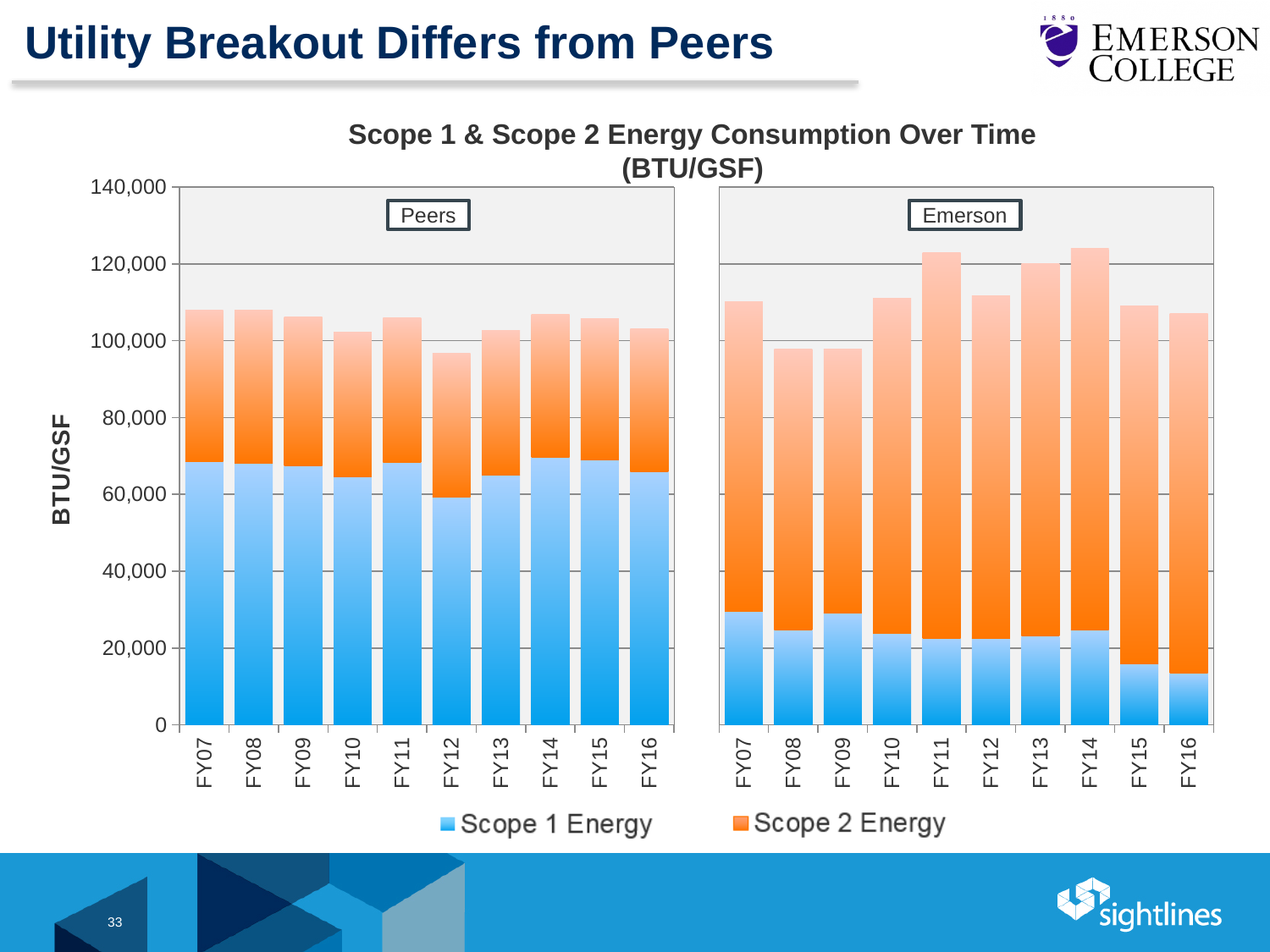
What kind of chart is shown on the slide? Stacked bar chart How many series does the legend list? 2 In the Peers panel, is the total value for FY12 greater or less than 100,000? less In the Emerson panel, which fiscal year has the lowest Scope 1 Energy value? FY16 In the Peers panel, which fiscal year has the lowest total energy consumption? FY12 In the Peers panel, which fiscal year has the lowest Scope 1 Energy value? FY12 What is the label on the vertical axis? BTU/GSF Which has the larger total energy consumption in FY11: Peers or Emerson? Emerson How many fiscal years are plotted in the Peers panel? 10 In the Emerson panel, is the total value for FY11 greater or less than 120,000? greater Which has the larger Scope 1 Energy value in FY07: Peers or Emerson? Peers In the Emerson panel, is the Scope 1 Energy value for FY16 greater or less than 20,000? less